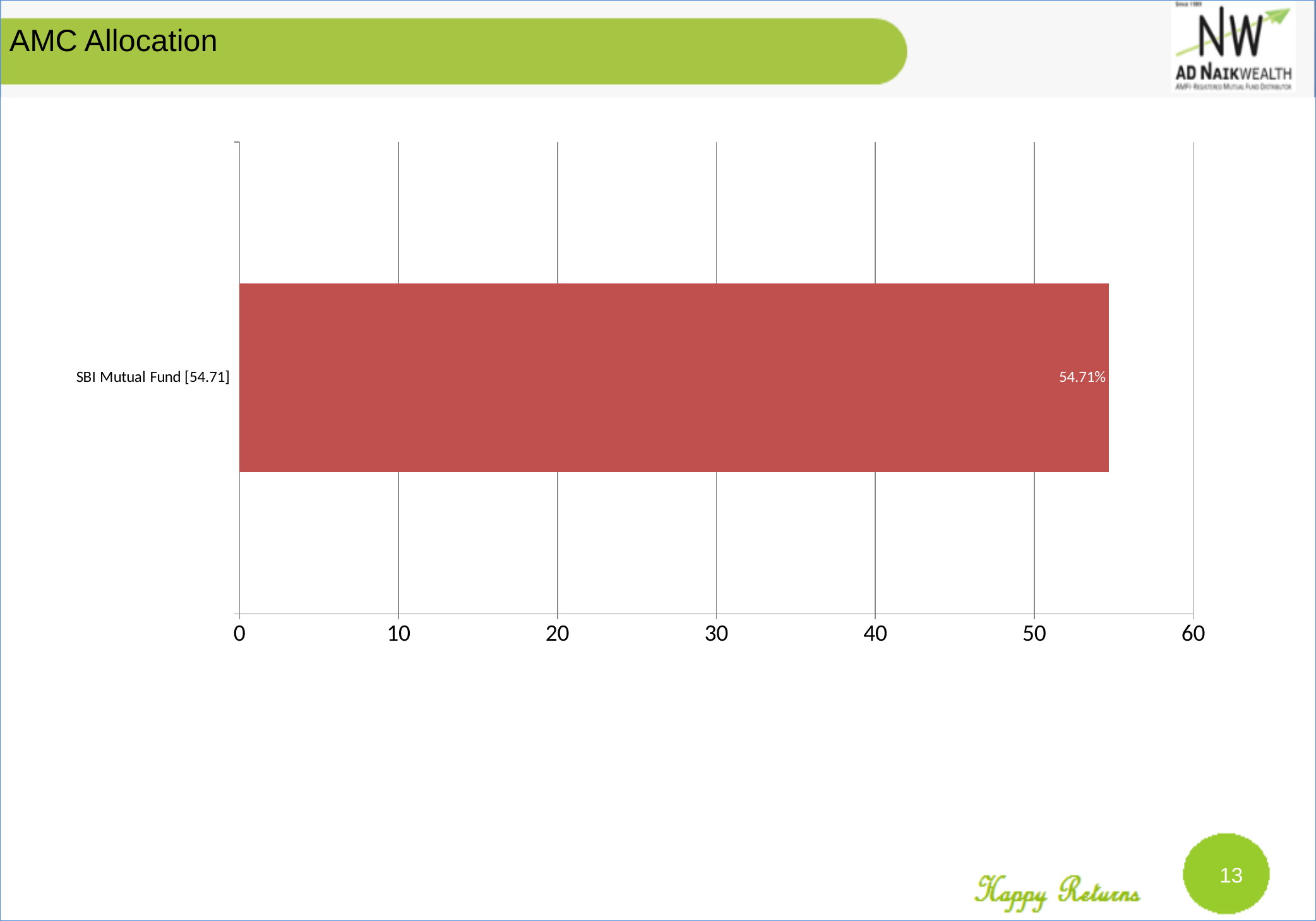
Which category has the highest value in the chart? SBI Mutual Fund What is the highest value shown on the horizontal axis? 60 What kind of chart is shown on the slide? bar chart How many categories are plotted in the chart? 1 What is the value shown for SBI Mutual Fund? 54.71% What is the title of the slide containing the chart? AMC Allocation Is the value for SBI Mutual Fund greater or less than 50? greater Is the value for SBI Mutual Fund greater or less than 60? less